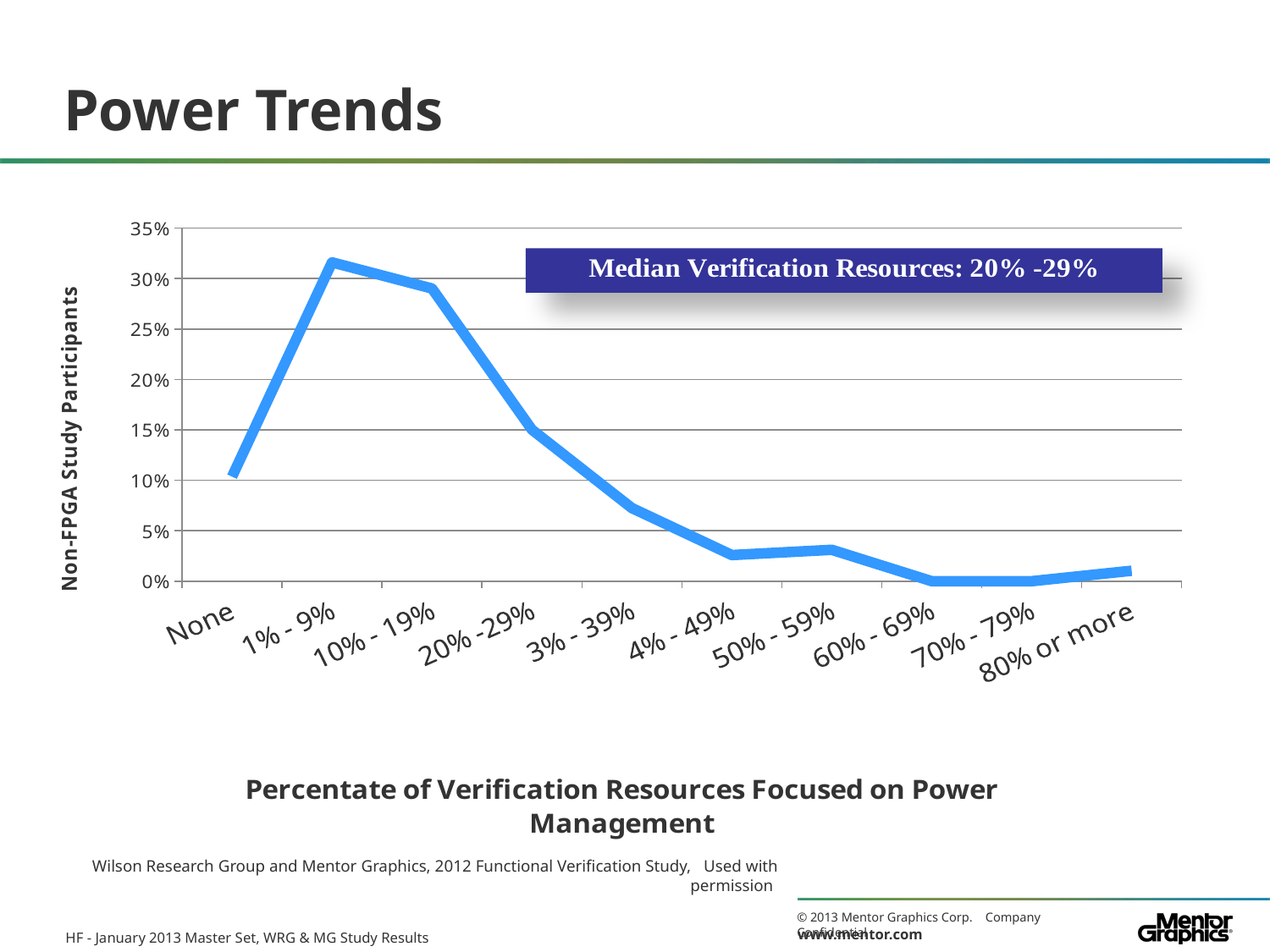
Which category has the highest value in the chart? 1% - 9% How many categories are shown along the x axis of the chart? 10 Do the values rise or fall along the x axis from 1% - 9% to 60% - 69%? fall What median verification resources range does the annotation on the chart state? 20% -29% Is the value for 10% - 19% greater or less than 25%? greater Is the value for 20% - 29% greater or less than 10%? greater What is the title of the chart? Percentate of Verification Resources Focused on Power Management What kind of chart is shown on the slide? line chart Is the value for None greater or less than 15%? less